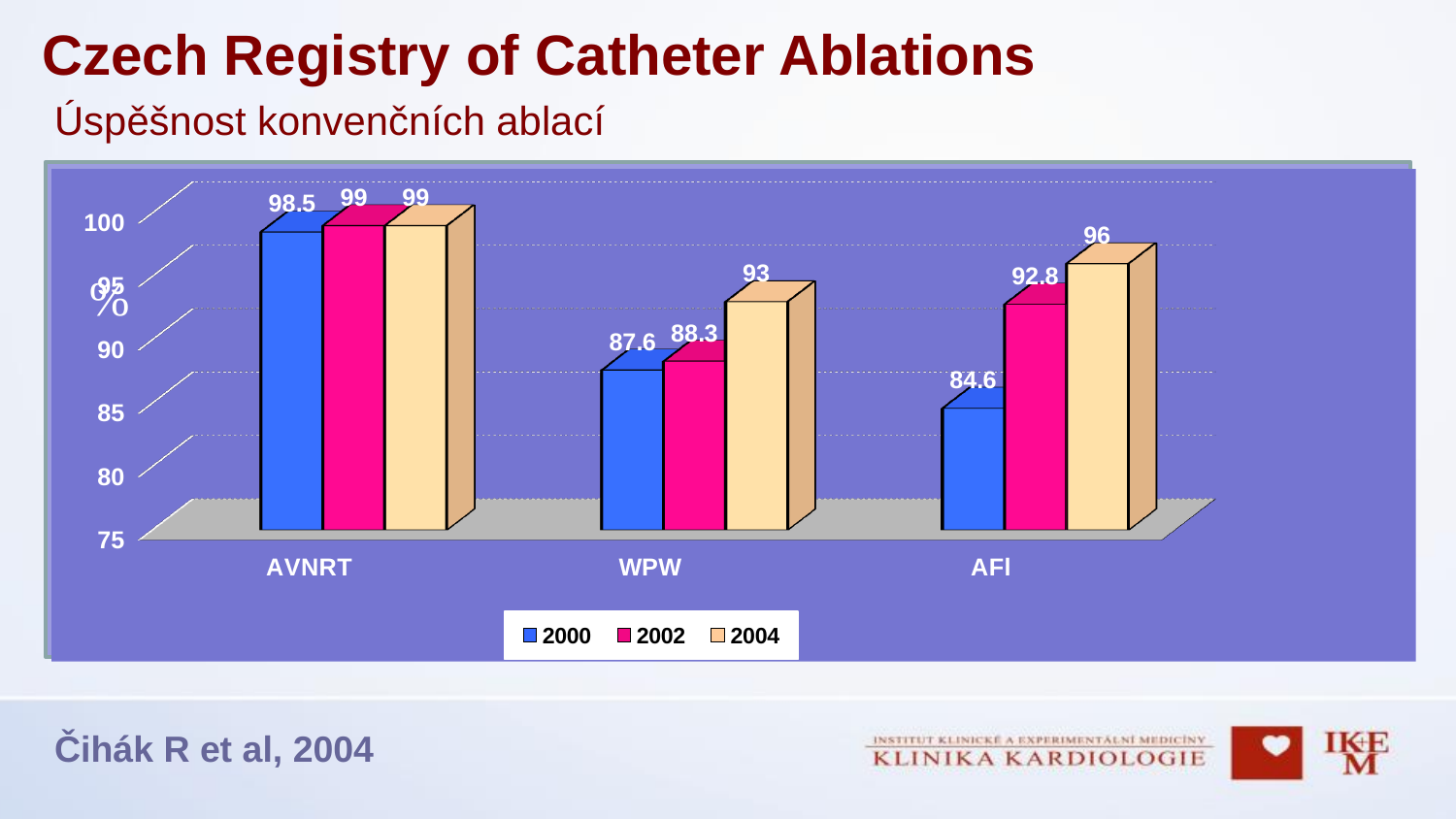
What is the value for AFl in 2002? 92.8 What is the difference between the 2004 and 2000 values for AFl? 11.4 What kind of chart is shown on the slide? bar chart What is the value for WPW in 2004? 93 How many categories are shown on the x axis? 3 What is the value for AFl in 2000? 84.6 Which is larger, the 2004 value for WPW or the 2004 value for AFl? AFl How many series does the legend list? 3 Which category has the highest value in 2004? AVNRT What is the difference between the 2002 and 2000 values for WPW? 0.7 What is the value for AVNRT in 2000? 98.5 Which category has the lowest value in 2000? AFl